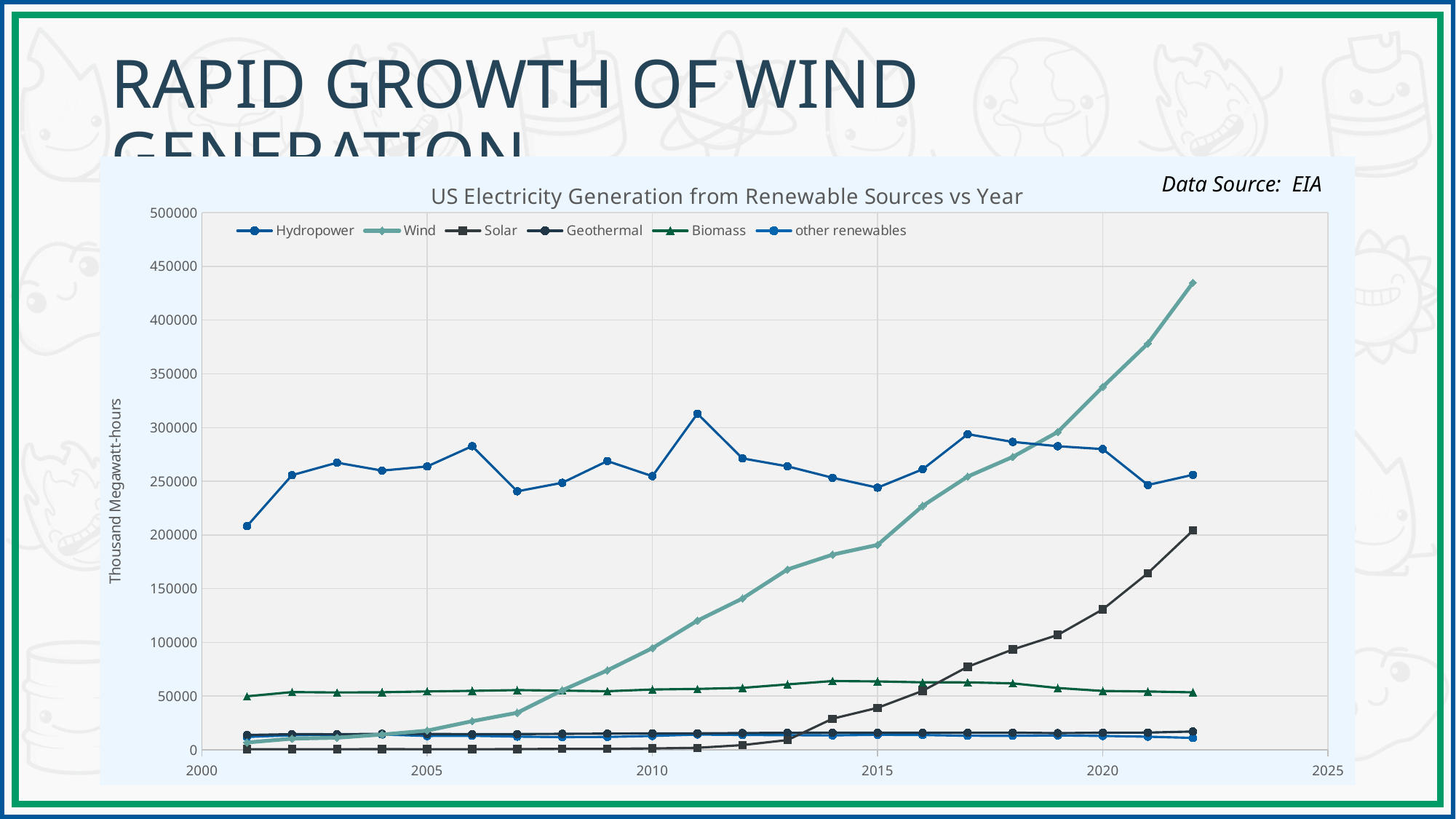
Is the value for Wind in 2022 greater or less than 400000? greater In 2010, which is larger, Hydropower or Wind? Hydropower What is the title of the chart? US Electricity Generation from Renewable Sources vs Year Is the value for Biomass in 2022 greater or less than 100000? less How many series does the chart's legend list? 6 Is the value for Hydropower in 2011 greater or less than 300000? greater What kind of chart is shown on the slide? line chart In 2022, which is larger, Wind or Hydropower? Wind Which series has the highest value in 2022? Wind What is the label on the chart's vertical axis? Thousand Megawatt-hours